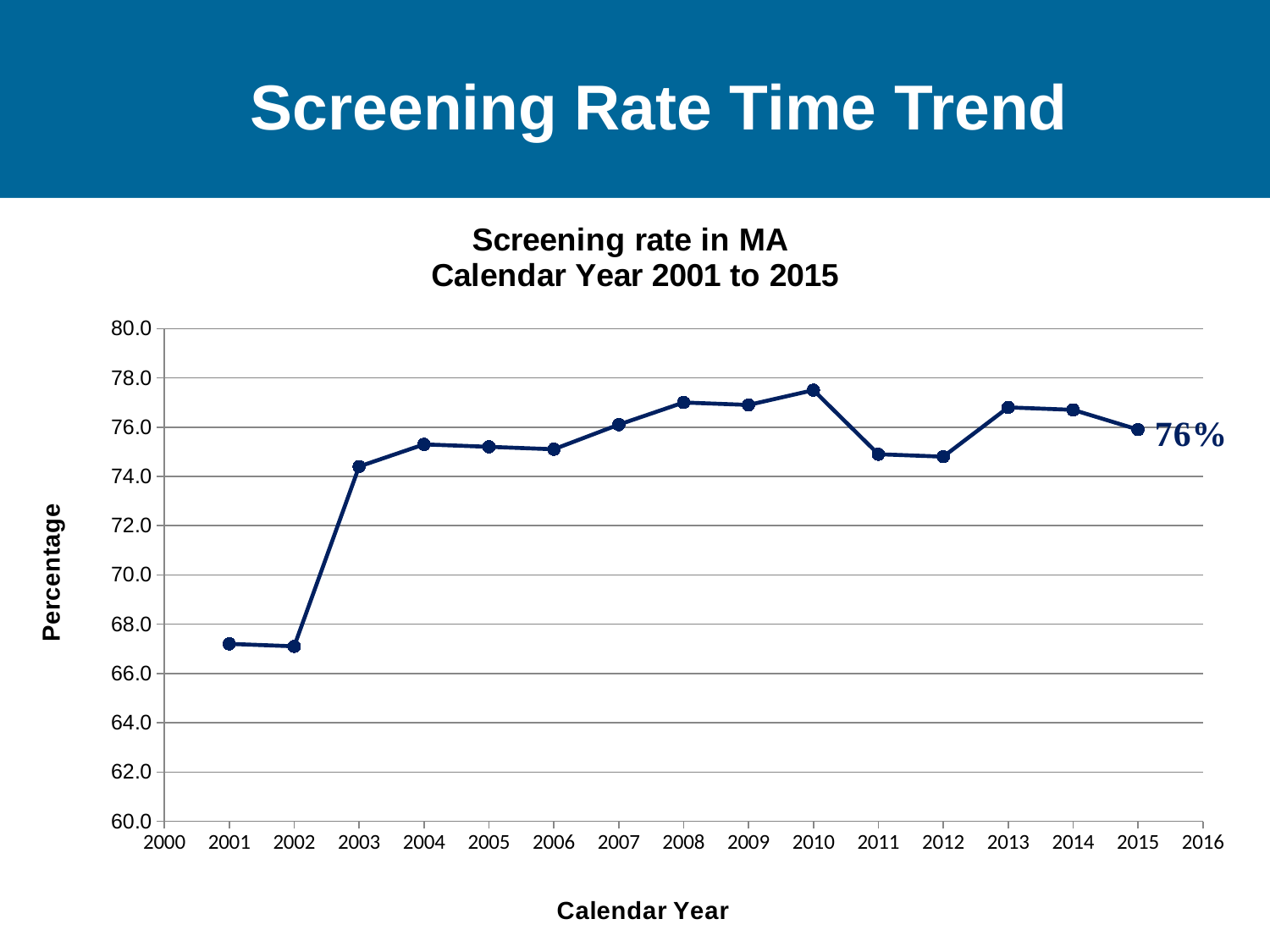
How many data points are plotted on the line? 15 What kind of chart is shown on the slide? Line chart Which year has the larger screening rate, 2002 or 2003? 2003 What is the label on the vertical axis of the chart? Percentage Is the value for 2011 greater or less than 76.0? less In which calendar year is the screening rate highest? 2010 Does the screening rate rise or fall from 2001 to 2003? Rise Is the value for 2003 greater or less than 74.0? greater Is the value for 2001 greater or less than 68.0? less What is the screening rate value labelled for 2015? 76% Which year has the larger screening rate, 2010 or 2012? 2010